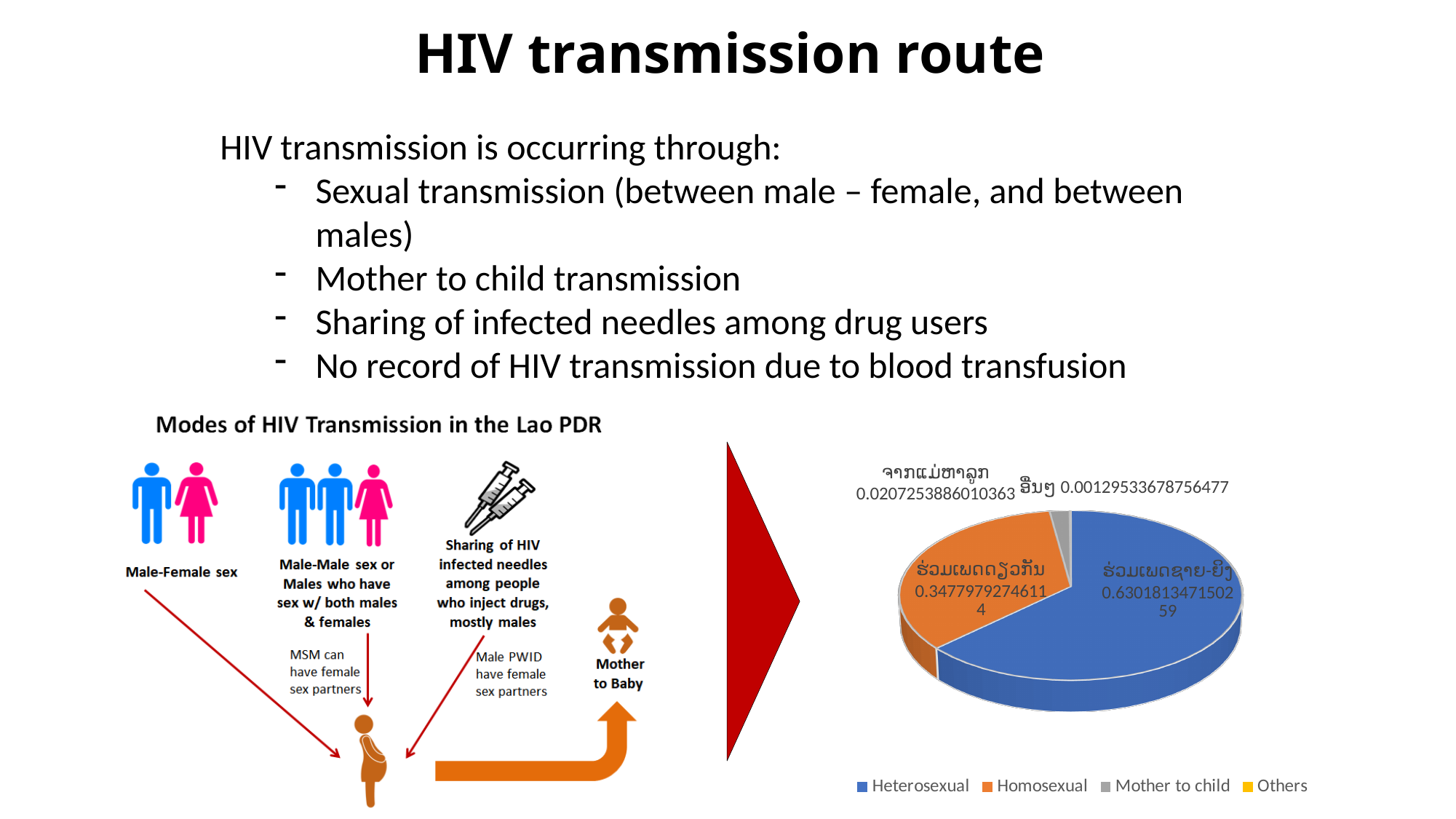
In the pie chart, what is the value shown for the Mother to child slice? 0.0207253886010363 How many slices does the pie chart have? 4 What kind of chart is shown on the right side of the slide? pie chart In the pie chart, what is the difference between the Heterosexual value and the Homosexual value? 0.282383419689119 How many entries does the legend of the pie chart list? 4 In the pie chart, what is the value shown for the Heterosexual slice? 0.630181347150259 In the pie chart, which is larger: the Homosexual slice or the Mother to child slice? Homosexual Which category has the largest slice in the pie chart? Heterosexual What colour is the Heterosexual slice in the pie chart? blue In the pie chart, what is the value shown for the Homosexual slice? 0.34779792746114 Which category has the smallest slice in the pie chart? Others In the pie chart, what is the value shown for the Others slice? 0.00129533678756477